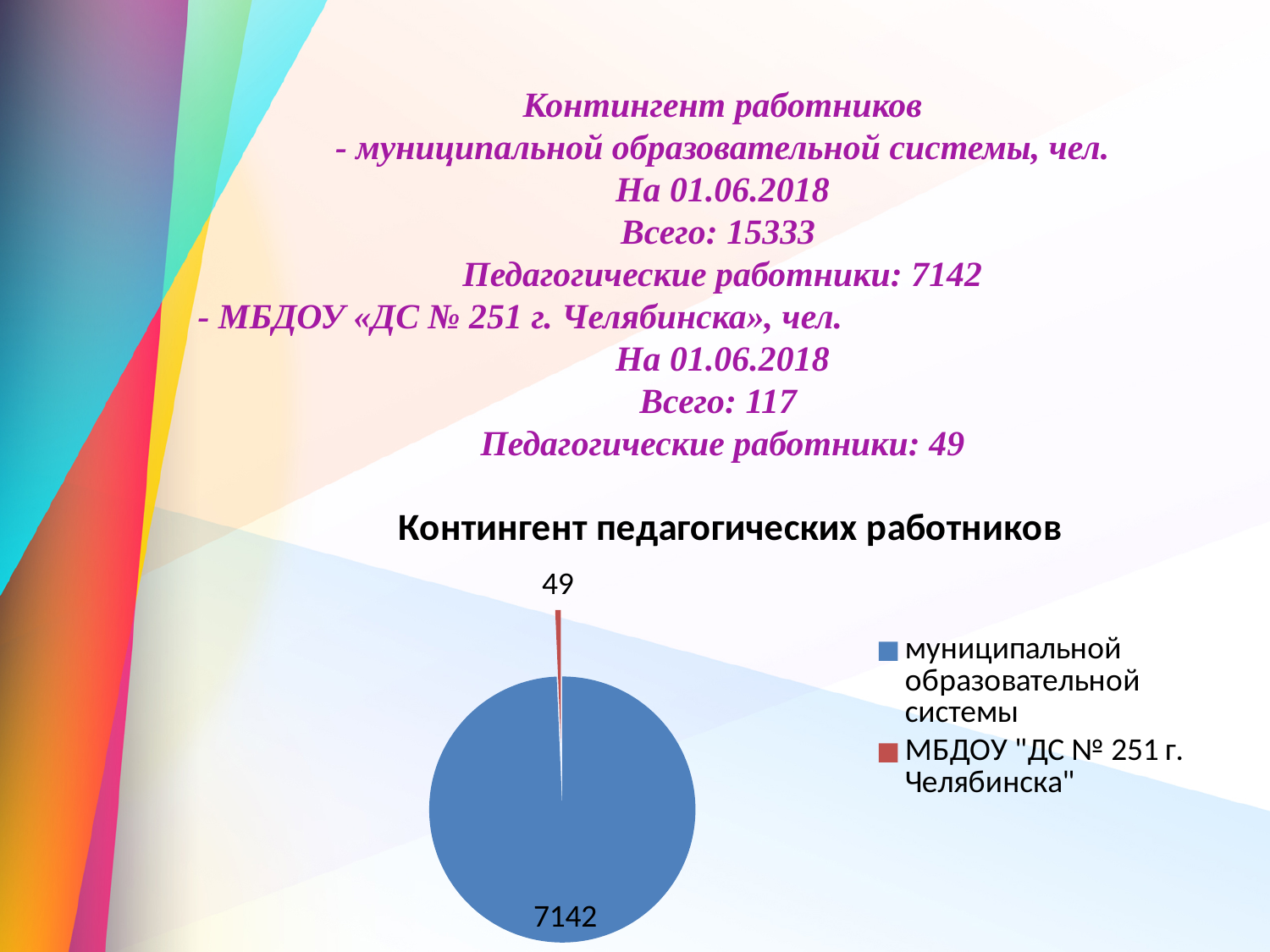
How many slices does the pie chart have? 2 Which category has the smallest slice in the pie chart? МБДОУ "ДС № 251 г. Челябинска" What is the title of the chart? Контингент педагогических работников How many entries does the legend list? 2 Which is larger: the value for муниципальной образовательной системы or the value for МБДОУ "ДС № 251 г. Челябинска"? муниципальной образовательной системы What is the value for муниципальной образовательной системы in the pie chart? 7142 What colour is the slice for МБДОУ "ДС № 251 г. Челябинска"? red Which category has the largest slice in the pie chart? муниципальной образовательной системы What kind of chart is shown on the slide? pie chart What is the total of the two values shown in the pie chart? 7191 What is the value for МБДОУ "ДС № 251 г. Челябинска" in the pie chart? 49 What is the difference between the value for муниципальной образовательной системы and the value for МБДОУ "ДС № 251 г. Челябинска"? 7093